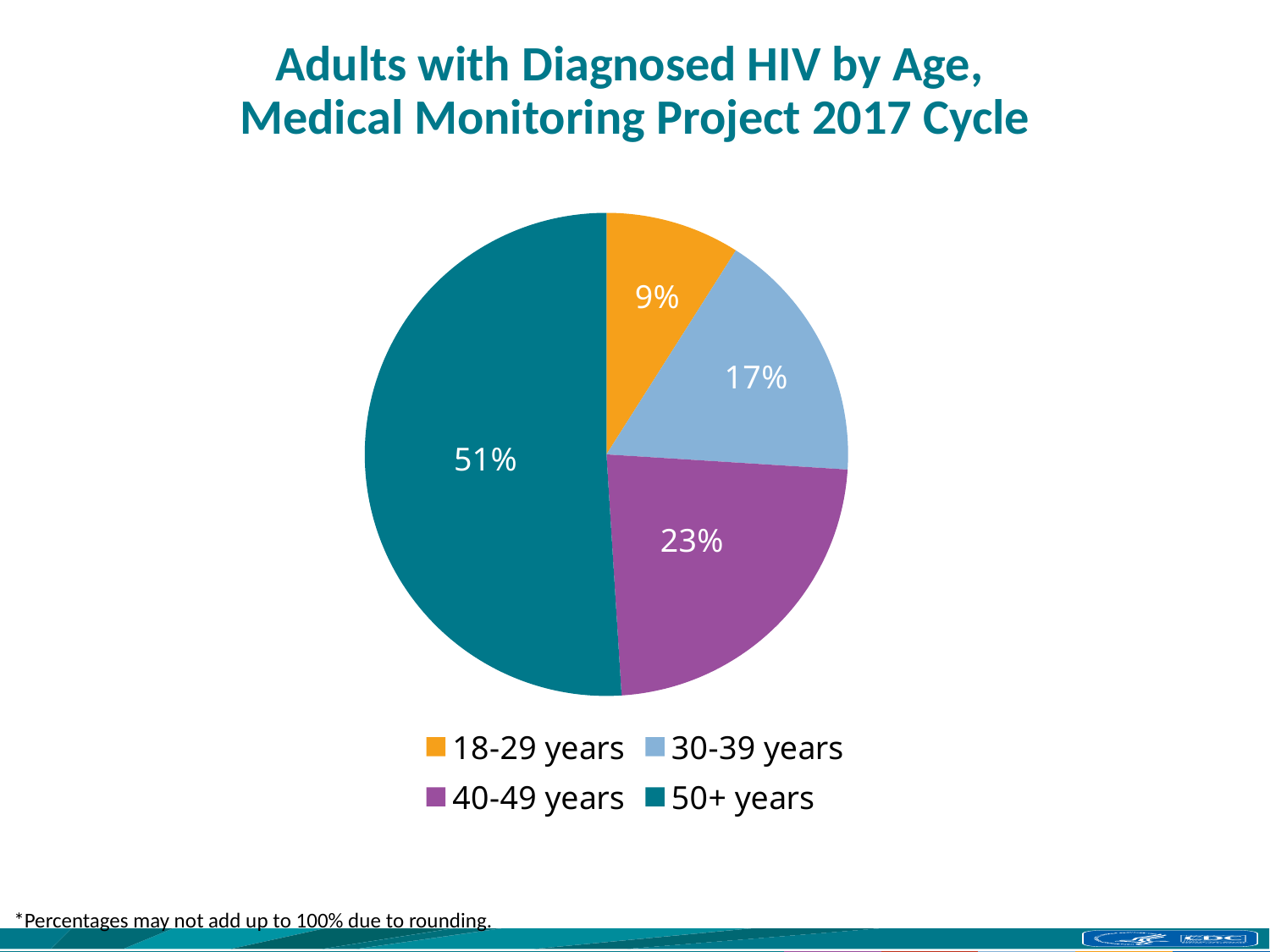
Which slice is larger, 30-39 years or 40-49 years? 40-49 years What percentage of adults with diagnosed HIV are aged 40-49 years? 23% What colour is the slice for 18-29 years? orange What percentage of adults with diagnosed HIV are aged 18-29 years? 9% What percentage of adults with diagnosed HIV are aged 50+ years? 51% What is the difference in percentage points between the 40-49 years and 30-39 years slices? 6 Which age group has the smallest share of the pie? 18-29 years What kind of chart is shown on the slide? pie chart How many age groups are shown in the pie chart? 4 Which age group has the largest share of the pie? 50+ years What percentage of adults with diagnosed HIV are aged 30-39 years? 17% What is the title of the chart? Adults with Diagnosed HIV by Age, Medical Monitoring Project 2017 Cycle